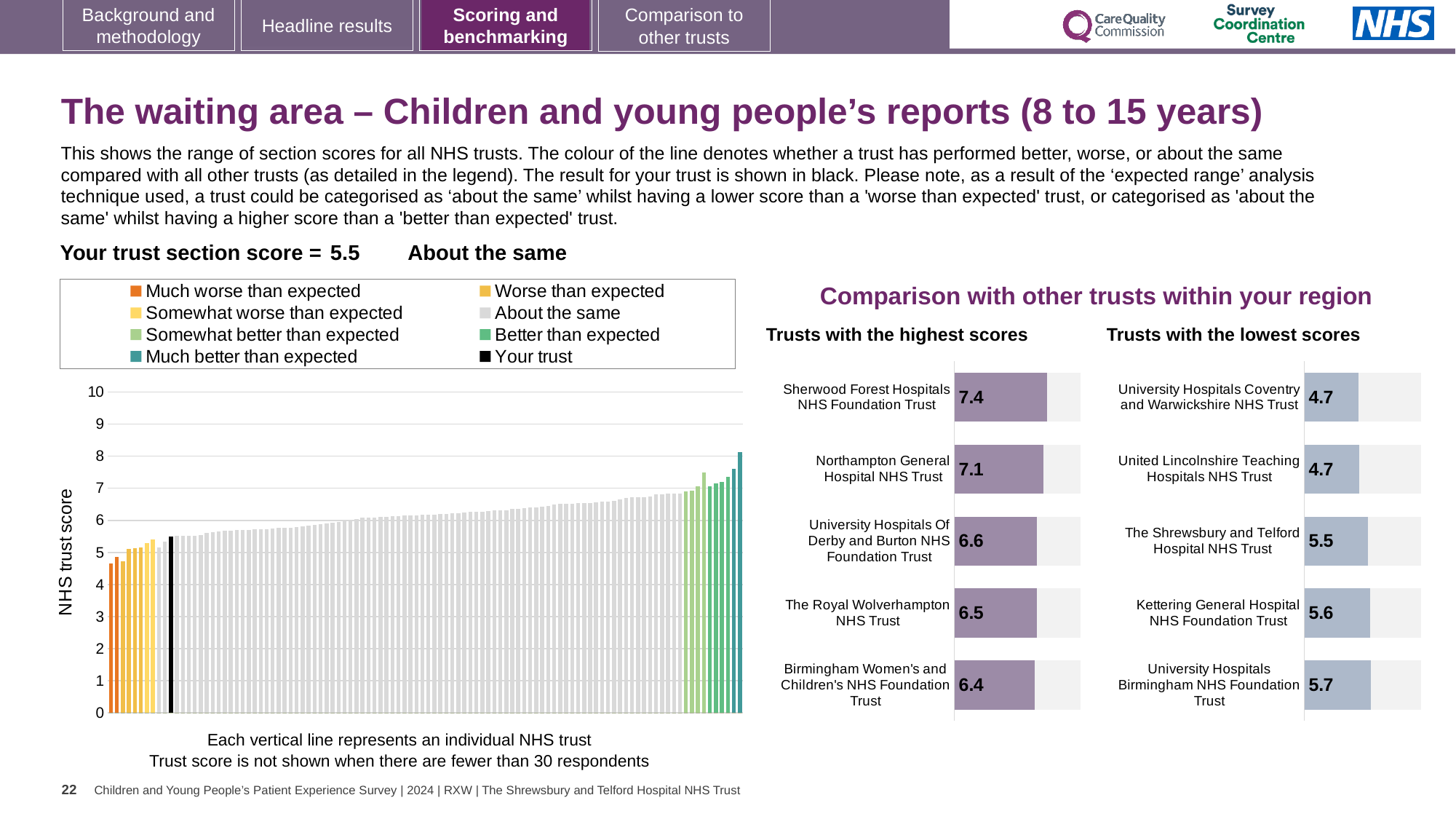
In the large chart on the left, is the value of the lowest bar greater or less than 5? less In the 'Trusts with the lowest scores' chart, which trust has the highest score? University Hospitals Birmingham NHS Foundation Trust In the 'Trusts with the lowest scores' chart, what is the score for Kettering General Hospital NHS Foundation Trust? 5.6 In the large chart on the left, what is the y-axis label? NHS trust score In the 'Trusts with the highest scores' chart, which trust has the highest score? Sherwood Forest Hospitals NHS Foundation Trust In the 'Trusts with the lowest scores' chart, which has the larger score: The Shrewsbury and Telford Hospital NHS Trust or Kettering General Hospital NHS Foundation Trust? Kettering General Hospital NHS Foundation Trust What kind of chart is the large chart on the left showing NHS trust scores? bar chart In the large chart on the left, is the value for the black 'Your trust' bar greater or less than 6? less In the 'Trusts with the highest scores' chart, what is the score for Northampton General Hospital NHS Trust? 7.1 In the 'Trusts with the highest scores' chart, how many trusts are shown? 5 In the 'Trusts with the highest scores' chart, what is the difference between the scores of Sherwood Forest Hospitals NHS Foundation Trust and Birmingham Women's and Children's NHS Foundation Trust? 1.0 In the large chart on the left, how many entries does the legend list? 8